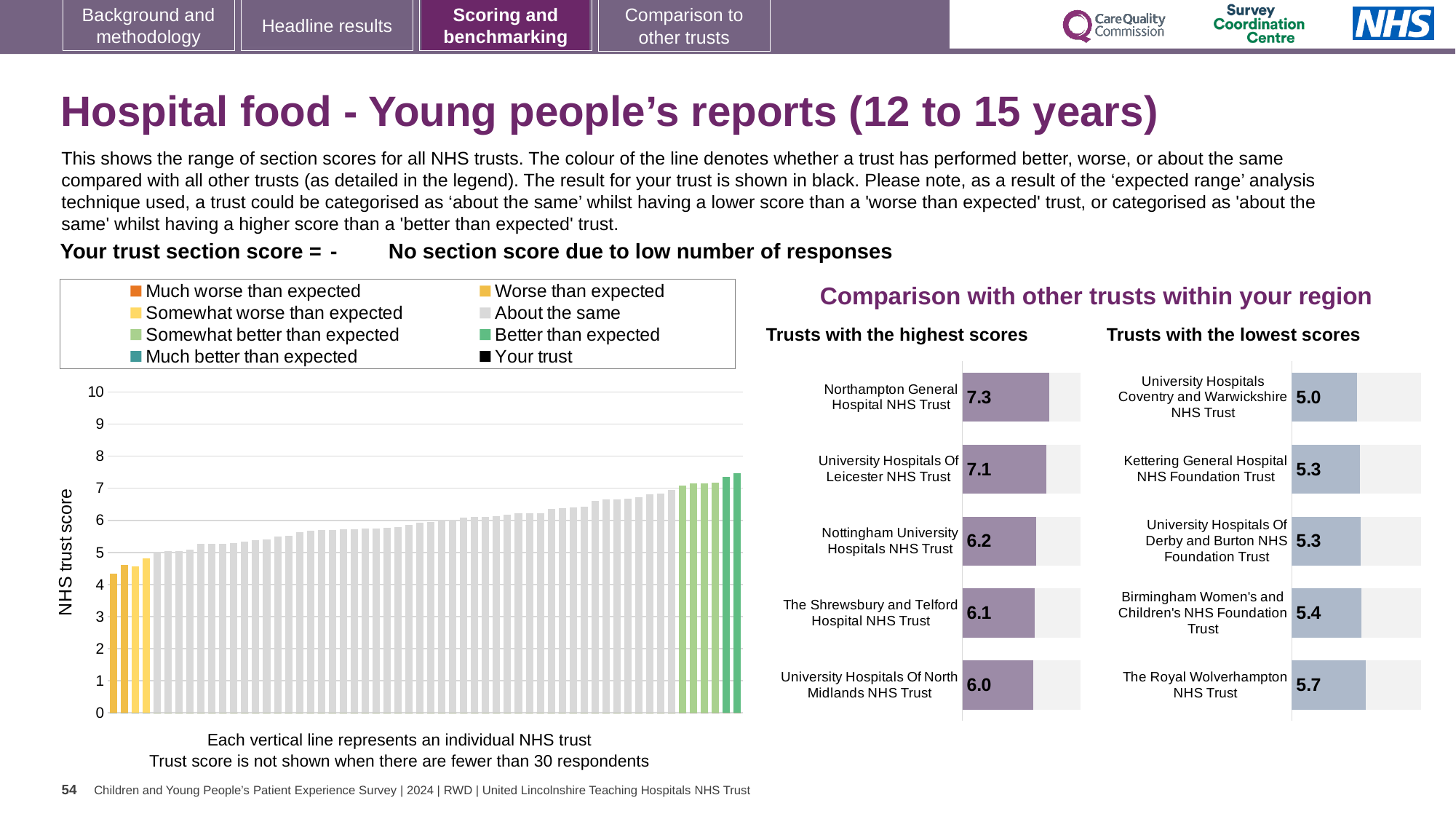
How many trusts are shown in the 'Trusts with the lowest scores' chart? 5 In the 'Trusts with the highest scores' chart, what is the score for Nottingham University Hospitals NHS Trust? 6.2 In the 'Trusts with the highest scores' chart, which trust has the lowest score? University Hospitals Of North Midlands NHS Trust In the 'Trusts with the lowest scores' chart, which trust has the highest score? The Royal Wolverhampton NHS Trust Which has the higher score: Kettering General Hospital NHS Foundation Trust in the lowest scores chart or The Shrewsbury and Telford Hospital NHS Trust in the highest scores chart? The Shrewsbury and Telford Hospital NHS Trust In the NHS trust score chart on the left, is the value of the shortest bar greater or less than 5? less In the 'Trusts with the highest scores' chart, what is the score for Northampton General Hospital NHS Trust? 7.3 In the 'Trusts with the lowest scores' chart, what is the score for University Hospitals Coventry and Warwickshire NHS Trust? 5.0 In the NHS trust score chart on the left, is the value of the tallest bar greater or less than 7? greater What type of chart is the NHS trust score chart on the left? bar chart In the 'Trusts with the highest scores' chart, what is the difference between the scores of Northampton General Hospital NHS Trust and University Hospitals Of Leicester NHS Trust? 0.2 In the 'Trusts with the lowest scores' chart, what is the score for The Royal Wolverhampton NHS Trust? 5.7